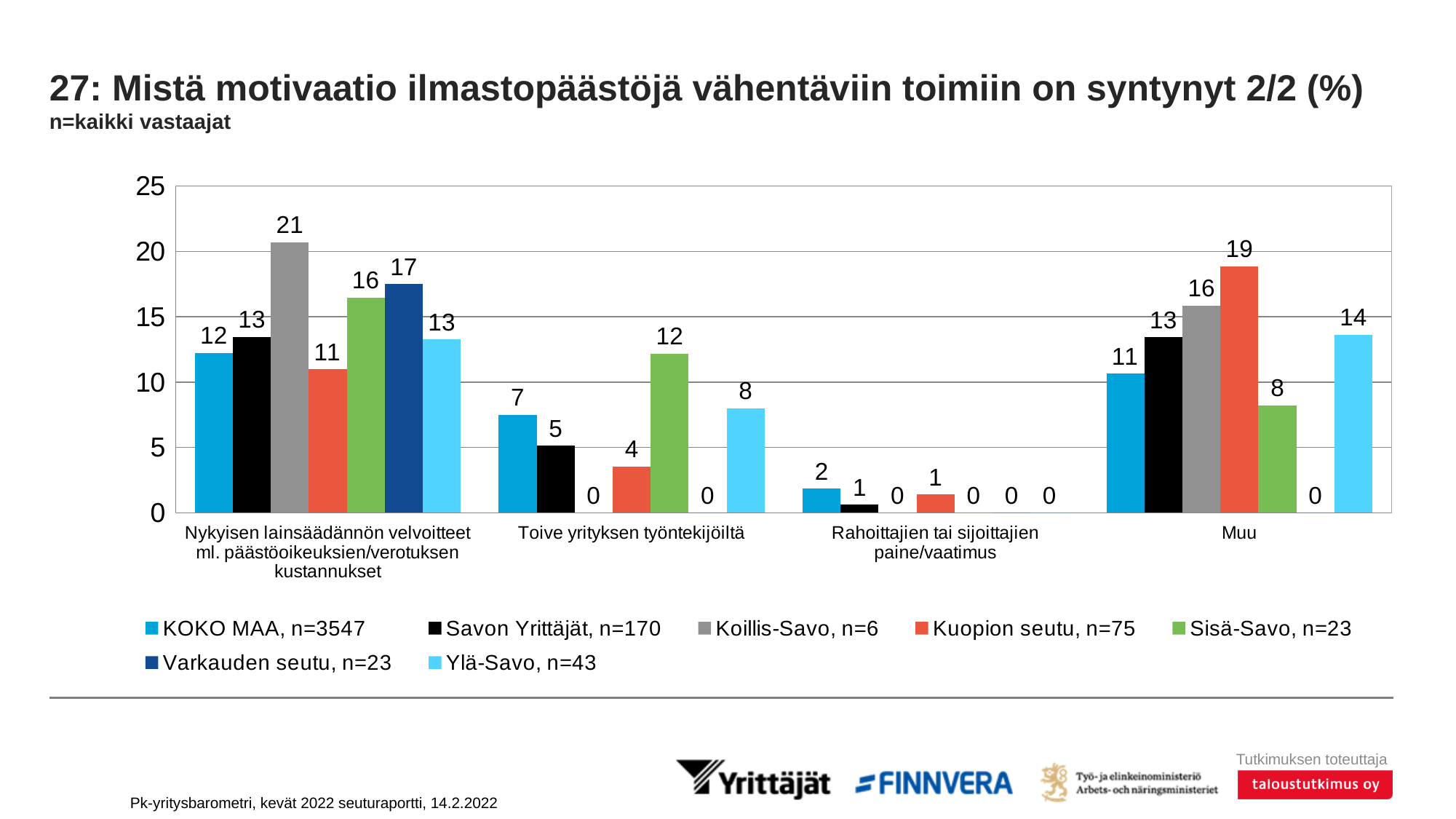
How many series does the legend list? 7 What is the difference between the Varkauden seutu, n=23 value and the KOKO MAA, n=3547 value in the category "Nykyisen lainsäädännön velvoitteet ml. päästöoikeuksien/verotuksen kustannukset"? 5 How many categories are shown on the x axis of the chart? 4 Is the value for Koillis-Savo, n=6 in the category "Nykyisen lainsäädännön velvoitteet ml. päästöoikeuksien/verotuksen kustannukset" greater or less than 20? greater What kind of chart is shown on the slide? bar chart In the category "Toive yrityksen työntekijöiltä", which is larger: the value for KOKO MAA, n=3547 or the value for Ylä-Savo, n=43? Ylä-Savo, n=43 What is the value for Sisä-Savo, n=23 in the category "Toive yrityksen työntekijöiltä"? 12 Which series has the lowest value in the category "Nykyisen lainsäädännön velvoitteet ml. päästöoikeuksien/verotuksen kustannukset"? Kuopion seutu, n=75 What is the value for KOKO MAA, n=3547 in the category "Rahoittajien tai sijoittajien paine/vaatimus"? 2 What is the value for Koillis-Savo, n=6 in the category "Nykyisen lainsäädännön velvoitteet ml. päästöoikeuksien/verotuksen kustannukset"? 21 Which series has the highest value in the category "Muu"? Kuopion seutu, n=75 What is the value for Kuopion seutu, n=75 in the category "Muu"? 19